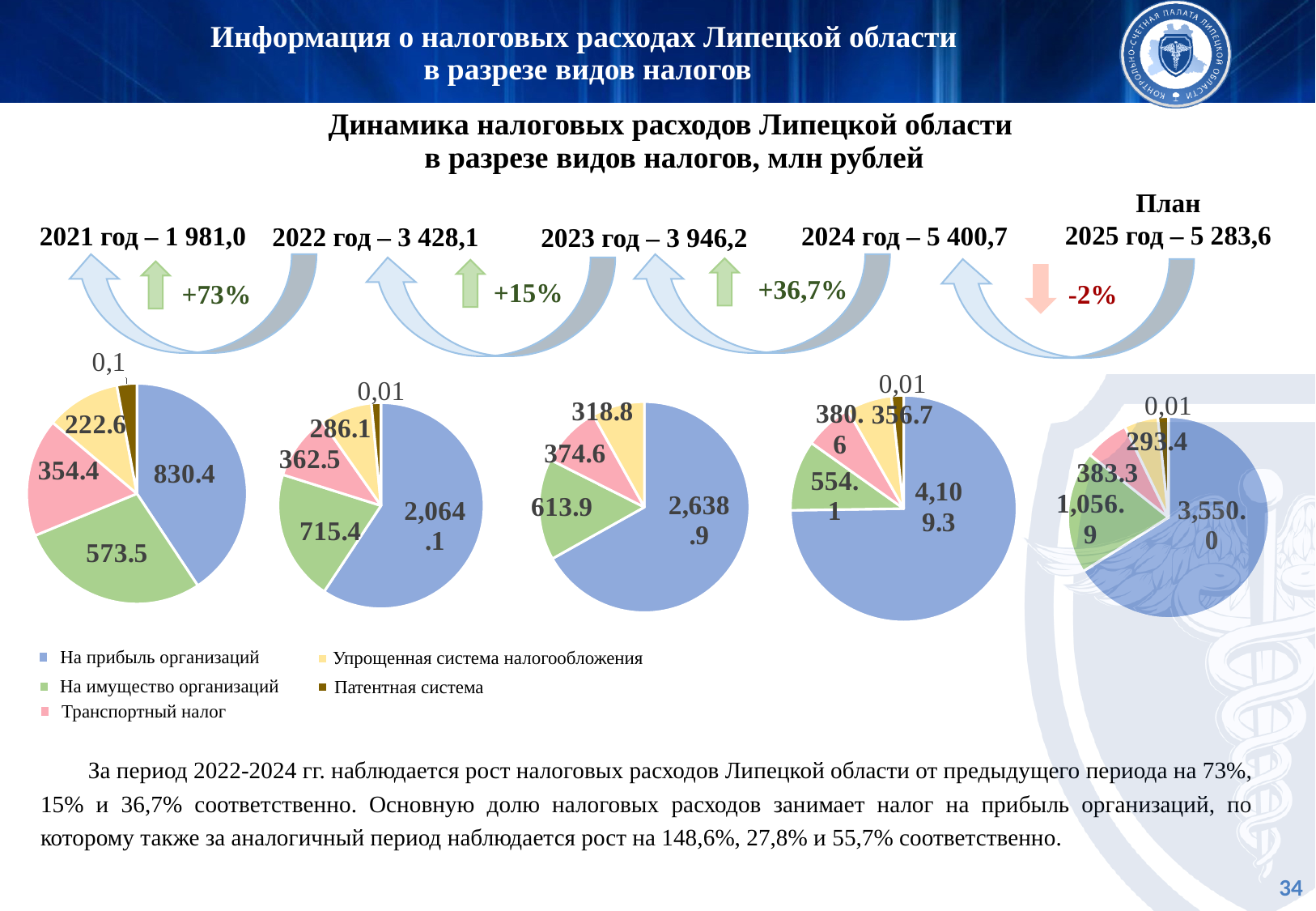
In the 2023 pie chart, what is the difference between На имущество организаций and Транспортный налог? 239.3 What is the total tax expenditure shown for 2024 год? 5 400,7 What type of charts are used to show the breakdown of tax expenditures by tax type? Pie charts In the 2021 pie chart, what is the value for На прибыль организаций? 830.4 In the 2023 pie chart, what is the value for Транспортный налог? 374.6 How many series does the legend list for the pie charts? 5 In the План 2025 pie chart, which is larger: На имущество организаций or Транспортный налог? На имущество организаций In the 2021 pie chart, which tax type has the smallest slice? Патентная система In the 2022 pie chart, what is the value for На имущество организаций? 715.4 In the План 2025 pie chart, what is the value for На прибыль организаций? 3,550.0 In the 2024 pie chart, which tax type has the largest slice? На прибыль организаций In the 2024 pie chart, what is the value for Упрощенная система налогообложения? 356.7